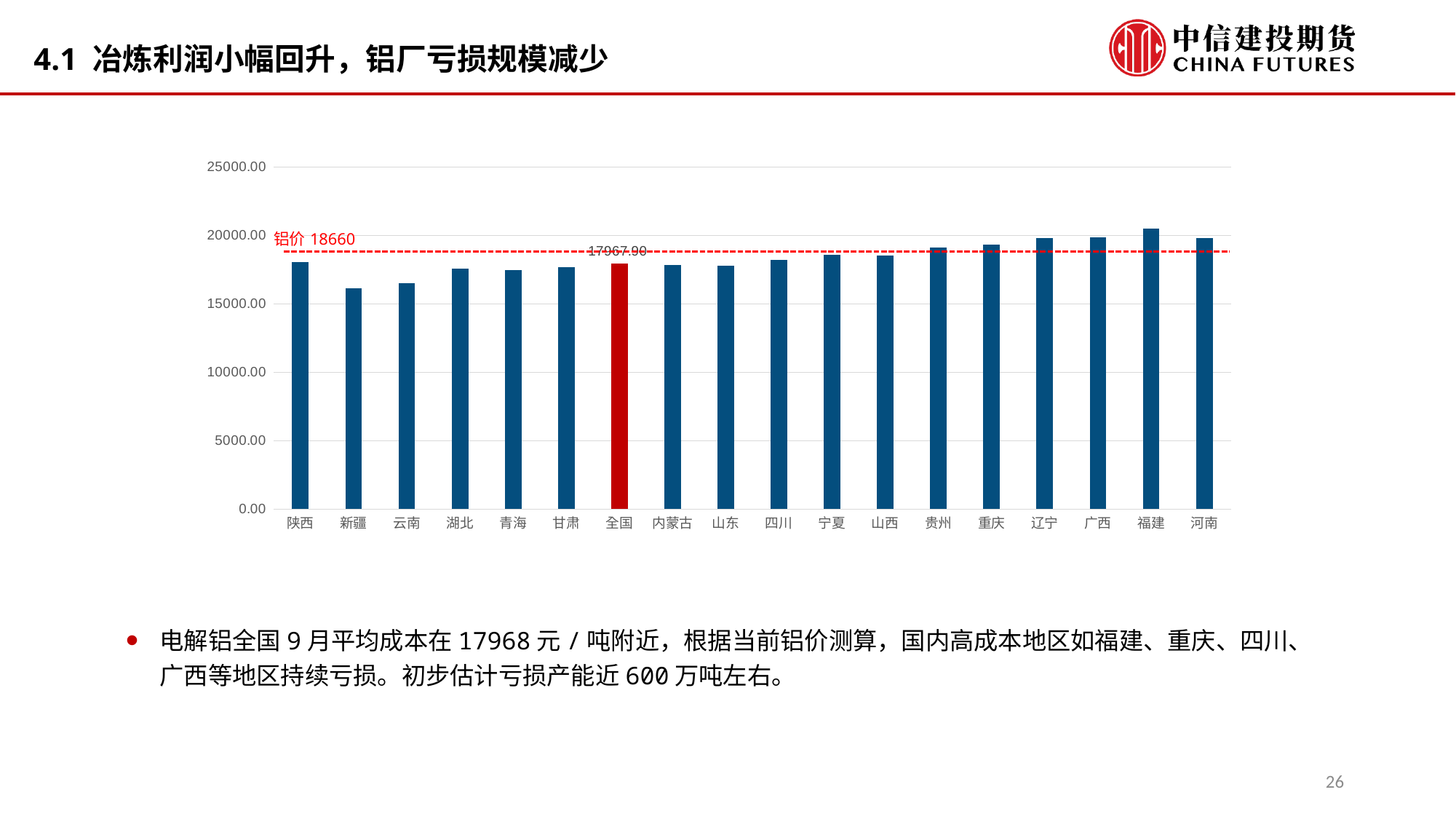
What label is printed on the red dashed horizontal line? 铝价 18660 Which category's bar is coloured red instead of blue? 全国 Which category has the lowest bar? 新疆 What kind of chart is shown on the slide? bar chart Is the value for 福建 greater or less than 20000? greater Which category has the highest bar? 福建 Which is larger, the value for 福建 or the value for 新疆? 福建 Which is larger, the value for 重庆 or the value for 云南? 重庆 How many categories are shown on the x axis? 18 Is the value for 云南 greater or less than 20000? less What value is printed on the 全国 bar? 17967.90 Is the value for 新疆 greater or less than 15000? greater